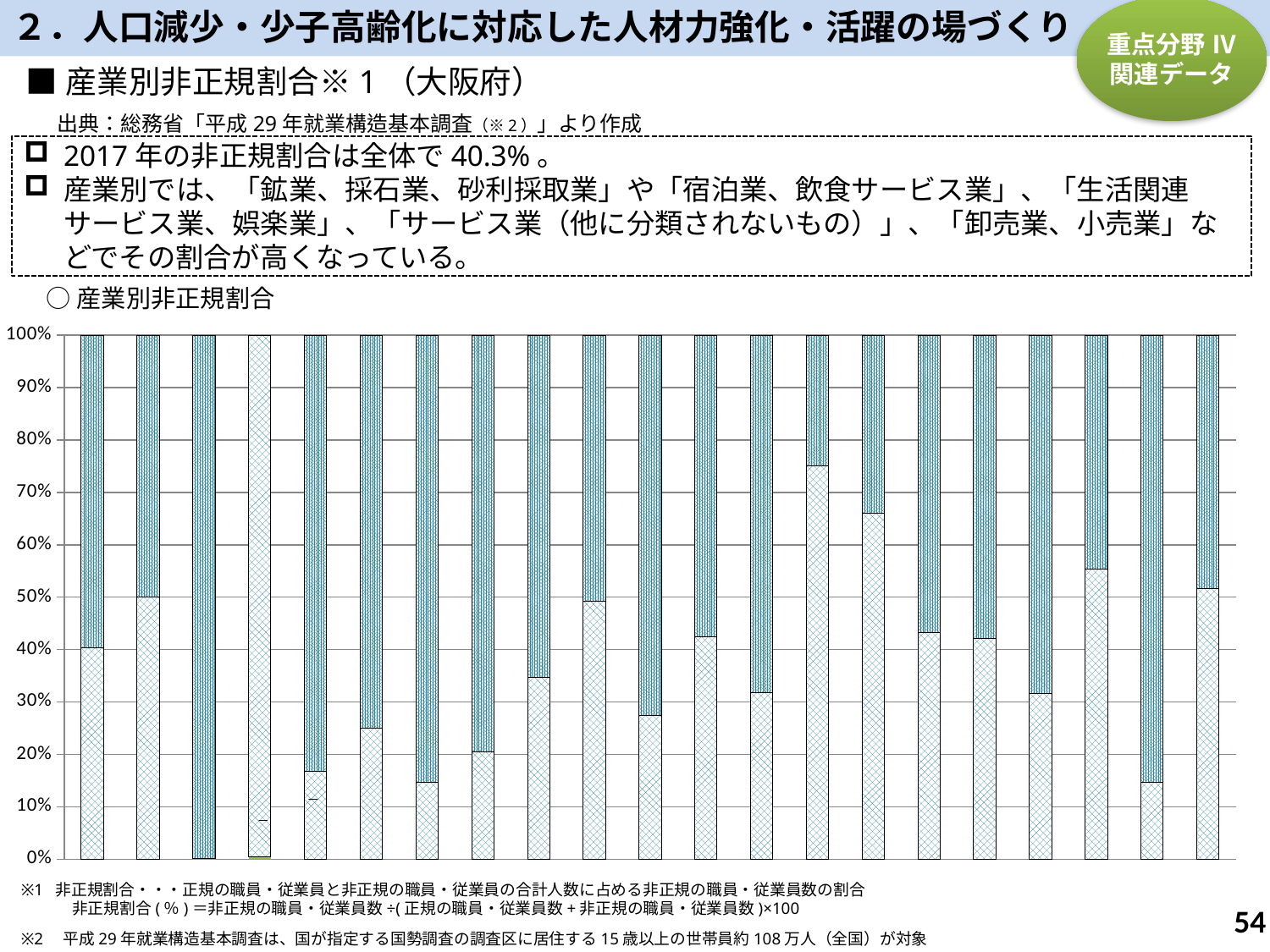
Is the lower segment of the fourth bar from the left in the chart greater or less than 90%? greater How many bars are plotted in the 産業別非正規割合 chart? 21 What is the highest value shown on the vertical axis of the chart? 100% Which bar in the chart has the largest lower segment? the fourth bar from the left What kind of chart is shown under the heading 産業別非正規割合? bar chart Is the lower segment of the leftmost bar in the chart greater or less than 30%? greater Is the lower segment of the third bar from the left in the chart greater or less than 10%? less What is the interval between consecutive tick labels on the vertical axis of the chart? 10%